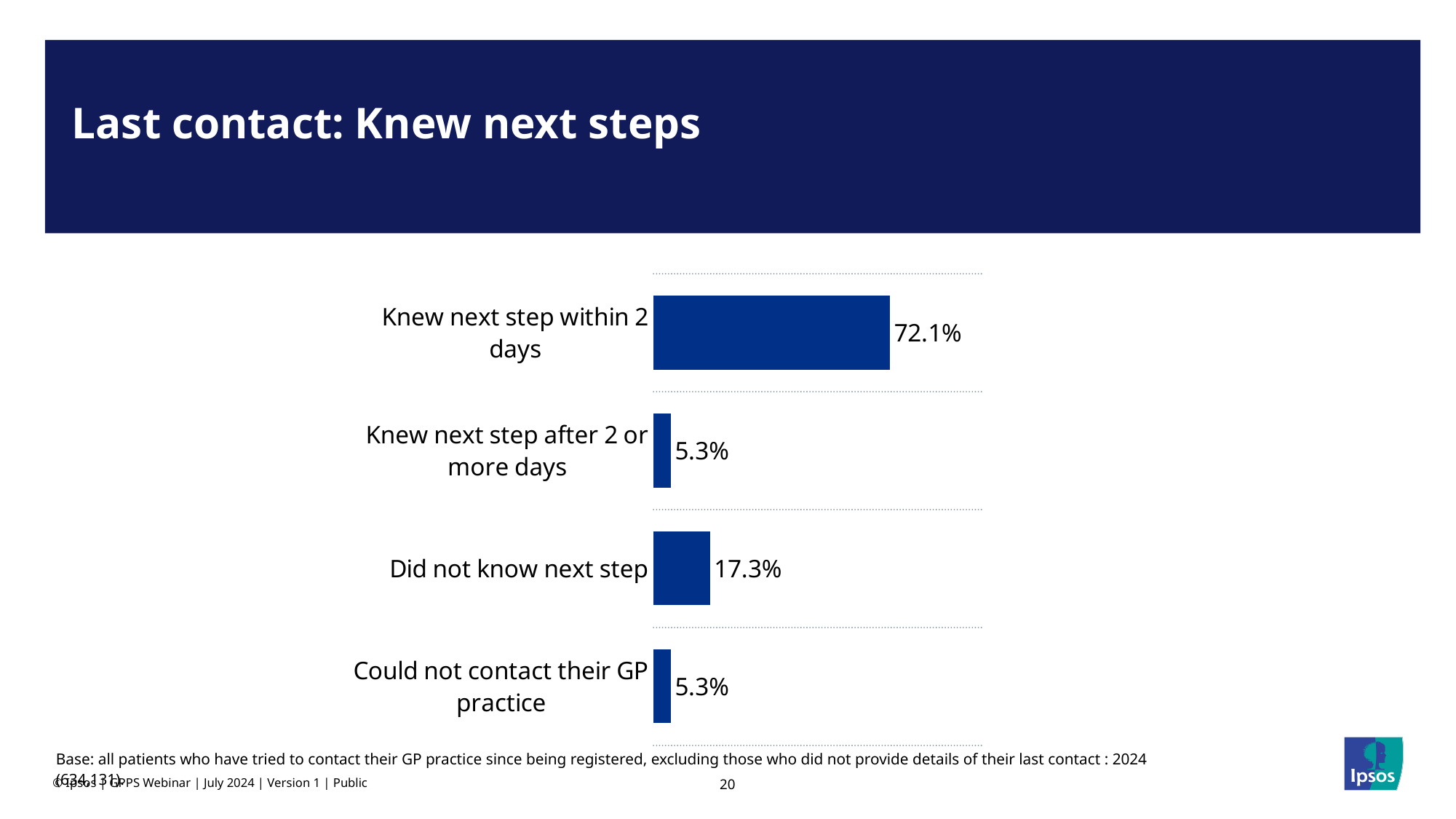
What kind of chart is shown on the slide? Bar chart What is the difference between 'Knew next step within 2 days' and 'Did not know next step'? 54.8 percentage points Which two categories share the same value of 5.3%? Knew next step after 2 or more days; Could not contact their GP practice Which category has the highest value? Knew next step within 2 days What is the difference between 'Did not know next step' and 'Could not contact their GP practice'? 12 percentage points What percentage of patients did not know the next step? 17.3% How many categories are shown in the chart? 4 What percentage of patients knew the next step after 2 or more days? 5.3% What percentage of patients could not contact their GP practice? 5.3% What is the title of the slide? Last contact: Knew next steps Which is larger: 'Did not know next step' or 'Knew next step after 2 or more days'? Did not know next step What percentage of patients knew the next step within 2 days? 72.1%